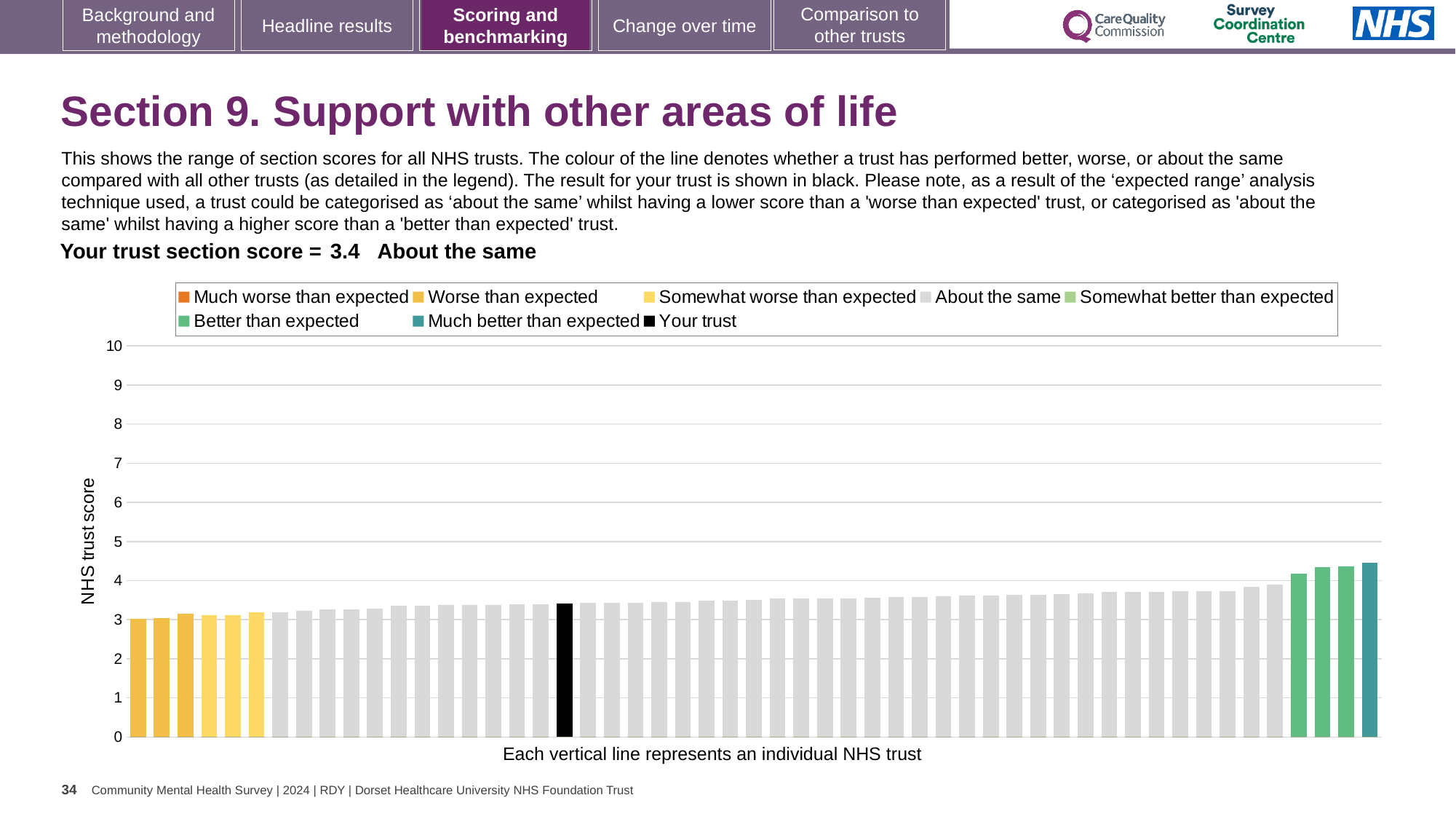
How many entries does the chart legend list? 8 Is the value of the lowest bar (the leftmost bar) greater or less than 4? less What kind of chart is shown on the slide? bar chart What is the highest value shown on the vertical axis? 10 How is your trust's section score categorised compared with other trusts? About the same What colour is the bar representing your trust? black Do the bar values rise or fall from left to right along the x axis? rise What is the label on the vertical axis of the chart? NHS trust score Is the value for your trust (the black bar) greater or less than 3? greater Is the value of the highest bar (the rightmost, teal bar) greater or less than 4? greater What is the section score for your trust? 3.4